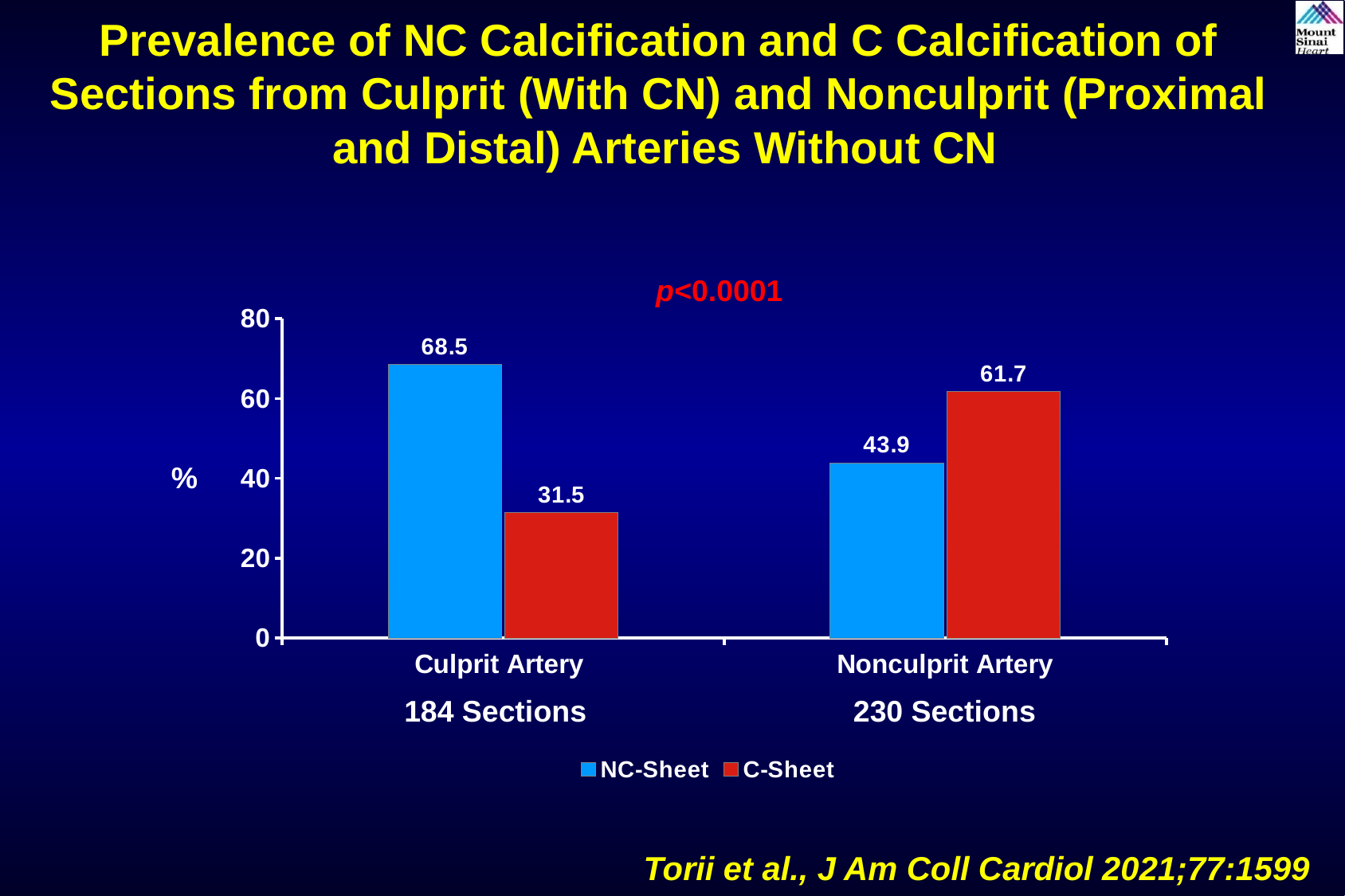
What is the C-Sheet value for Culprit Artery? 31.5 What is the difference between the NC-Sheet and C-Sheet values for Culprit Artery? 37 Which is larger for Nonculprit Artery: NC-Sheet or C-Sheet? C-Sheet What is the C-Sheet value for Nonculprit Artery? 61.7 Which bar has the highest value in the chart? NC-Sheet, Culprit Artery What p-value is shown above the chart? p<0.0001 What is the difference between the C-Sheet and NC-Sheet values for Nonculprit Artery? 17.8 Which bar has the lowest value in the chart? C-Sheet, Culprit Artery Is the NC-Sheet value for Nonculprit Artery greater or less than 40? greater What kind of chart is shown on the slide? bar chart What is the NC-Sheet value for Culprit Artery? 68.5 How many series does the legend list? 2